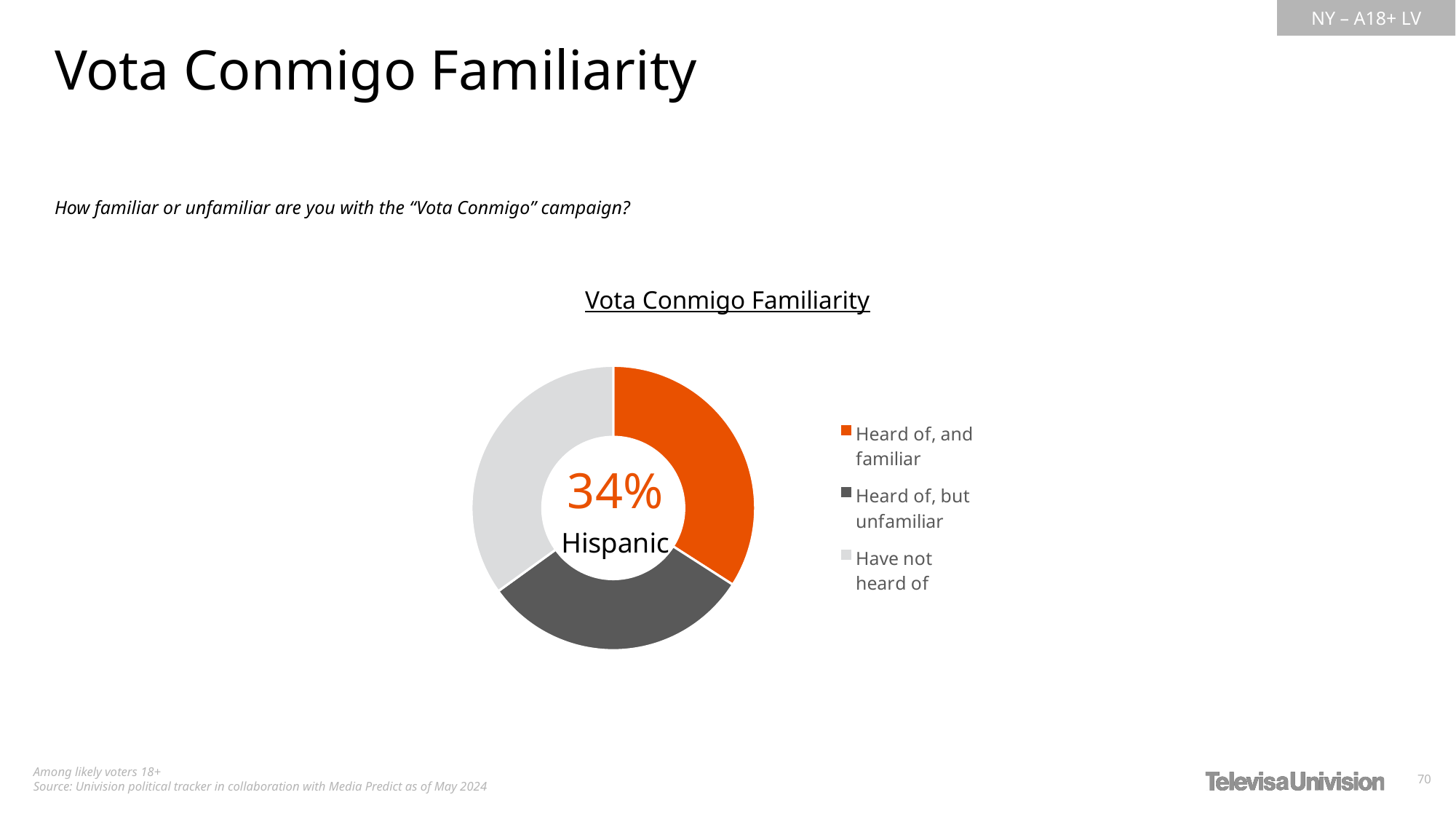
What kind of chart is shown on the slide? donut (pie) chart What share of Hispanic likely voters have heard of, and are familiar with, the Vota Conmigo campaign? 34% How many categories does the chart's legend list? 3 Is the share for 'Heard of, and familiar' greater or less than 50%? less Which group label appears in the centre of the donut chart below the percentage? Hispanic Is the share for 'Have not heard of' greater or less than 50%? less Is the share for 'Heard of, but unfamiliar' greater or less than 50%? less What percentage is printed in the centre of the donut chart? 34% What is the title of the chart? Vota Conmigo Familiarity How many slices does the donut chart have? 3